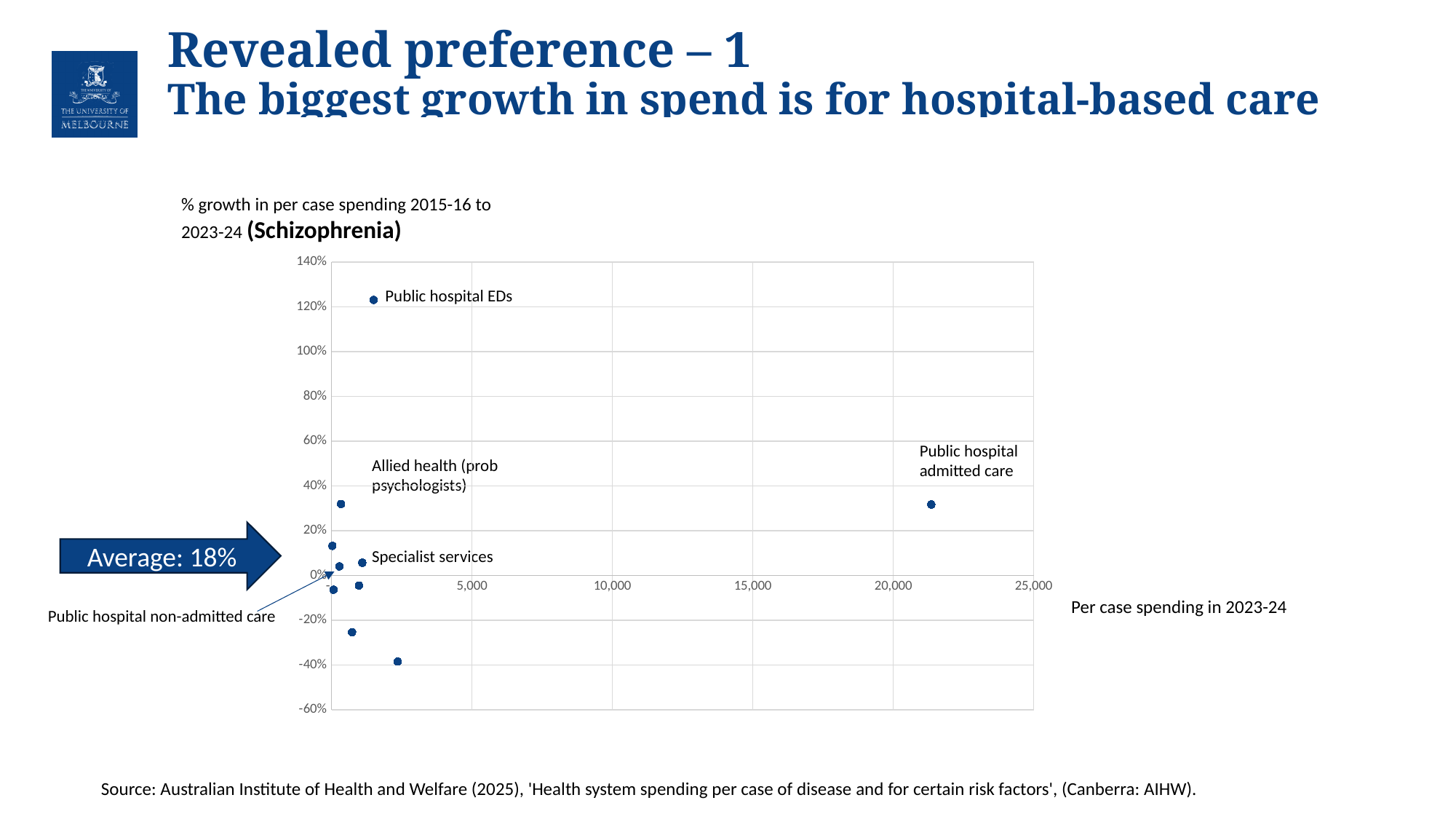
Which has the higher % growth: Allied health (prob psychologists) or Specialist services? Allied health (prob psychologists) Is the % growth for Specialist services greater or less than 20%? less What average % growth is called out on the slide next to the chart? 18% What is the label of the horizontal axis of the chart? Per case spending in 2023-24 Which labelled category has the highest % growth in per case spending? Public hospital EDs Is the per case spending in 2023-24 for Public hospital admitted care greater or less than 20,000? greater Is the % growth for Public hospital EDs greater or less than 100%? greater What kind of chart is shown on the slide? Scatter chart Which has the higher % growth in per case spending: Public hospital EDs or Public hospital admitted care? Public hospital EDs Which has the higher per case spending in 2023-24: Public hospital admitted care or Allied health (prob psychologists)? Public hospital admitted care Which labelled category has the highest per case spending in 2023-24? Public hospital admitted care